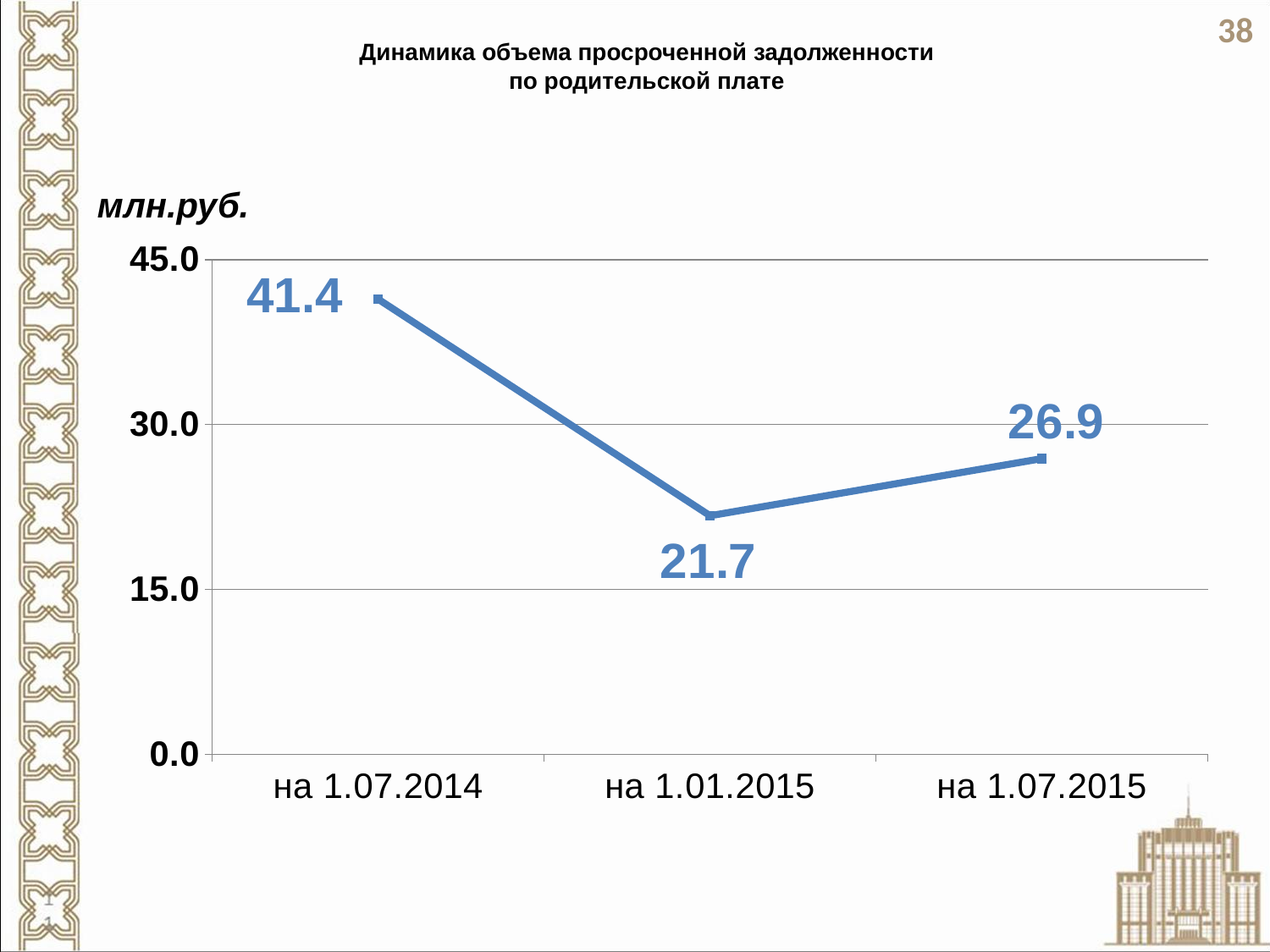
Is the value for на 1.07.2015 greater or less than 30.0? less What is the difference between the values for на 1.07.2015 and на 1.01.2015? 5.2 Which is larger, the value for на 1.07.2014 or the value for на 1.07.2015? на 1.07.2014 Which date has the highest value? на 1.07.2014 What is the value for на 1.01.2015? 21.7 What kind of chart is shown on the slide? line chart How many data points are plotted on the chart? 3 What is the difference between the values for на 1.07.2014 and на 1.01.2015? 19.7 What unit is shown above the vertical axis of the chart? млн.руб. What is the value for на 1.07.2014? 41.4 Which date has the lowest value? на 1.01.2015 What is the value for на 1.07.2015? 26.9